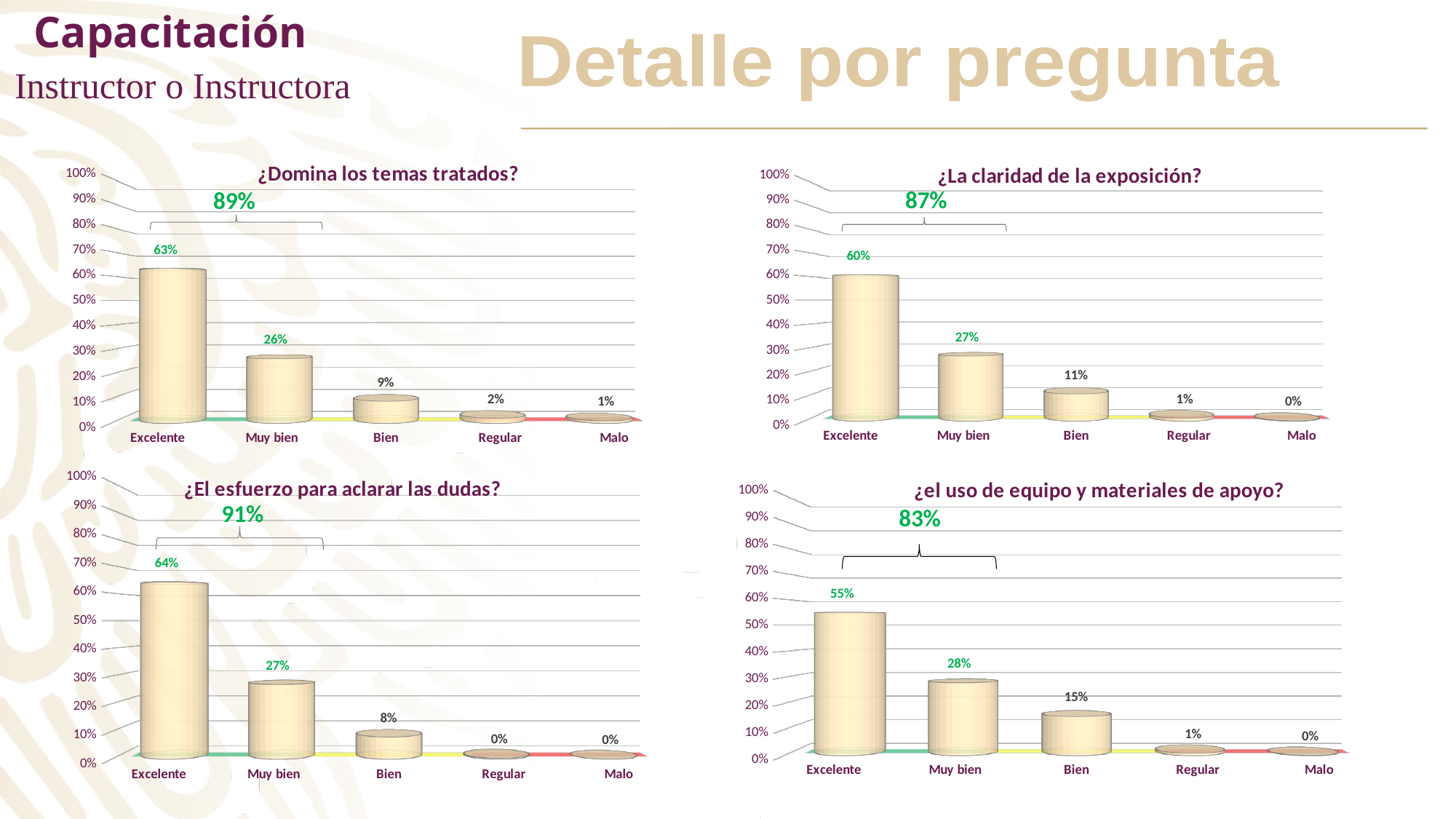
In the chart titled "¿Domina los temas tratados?", what is the value for Excelente? 63% What kind of chart is the chart titled "¿La claridad de la exposición?"? bar chart How many categories are shown on the x axis of the chart titled "¿Domina los temas tratados?"? 5 In the chart titled "¿El esfuerzo para aclarar las dudas?", what is the value for Muy bien? 27% In the chart titled "¿el uso de equipo y materiales de apoyo?", which category has the highest value? Excelente In the chart titled "¿El esfuerzo para aclarar las dudas?", which is larger, the value for Bien or the value for Muy bien? Muy bien In the chart titled "¿Domina los temas tratados?", which category has the lowest value? Malo In the chart titled "¿La claridad de la exposición?", what is the difference between the values for Excelente and Muy bien? 33% What combined percentage is shown above the bracket in the chart titled "¿El esfuerzo para aclarar las dudas?"? 91% In the chart titled "¿el uso de equipo y materiales de apoyo?", what is the value for Excelente? 55% In the chart titled "¿La claridad de la exposición?", what is the value for Bien? 11% In the chart titled "¿el uso de equipo y materiales de apoyo?", do the values rise or fall from Excelente to Malo? fall